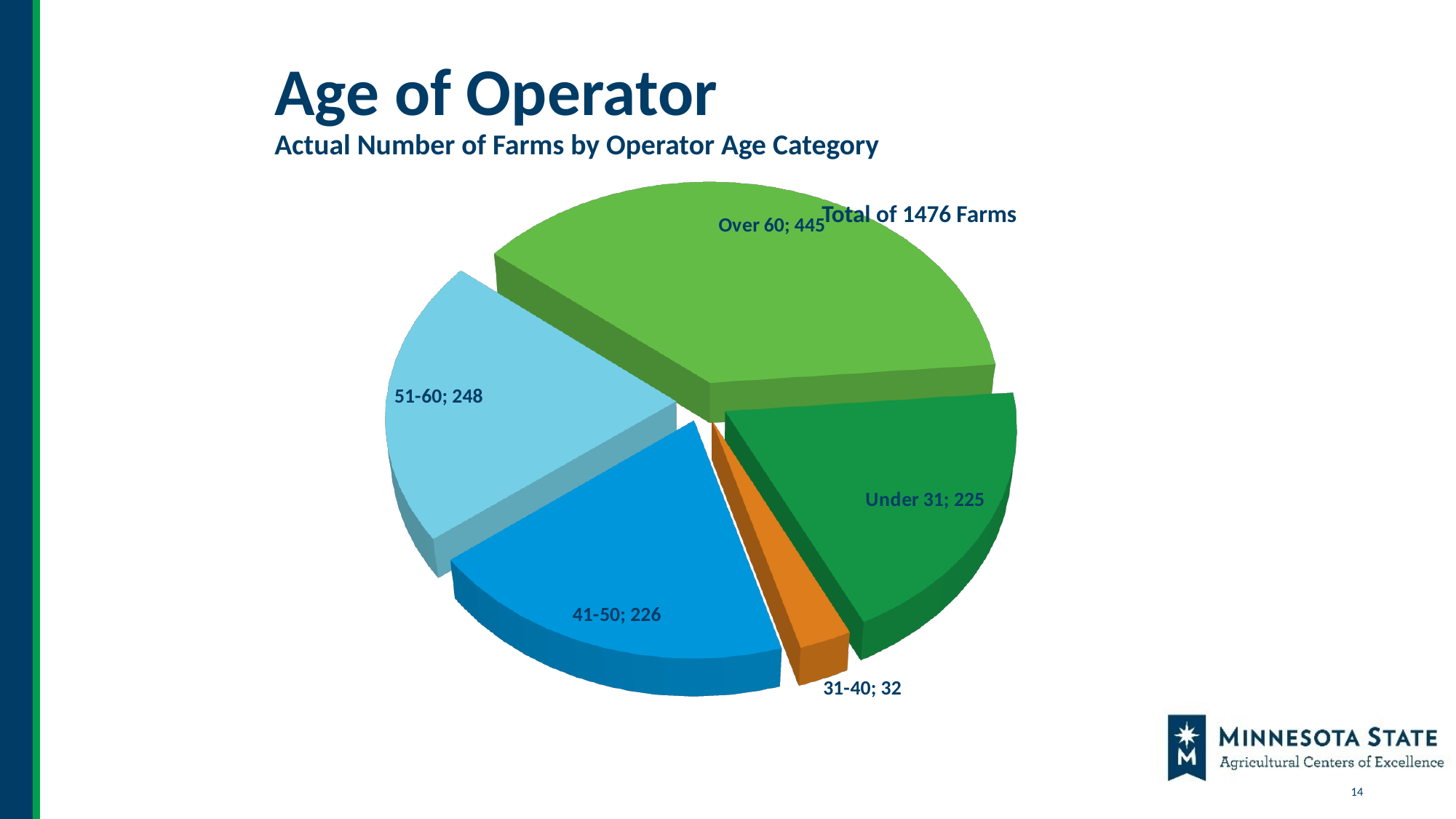
What kind of chart is shown on the slide? Pie chart Which operator age category has the smallest number of farms? 31-40 How many operator age categories are shown in the pie chart? 5 What is the difference in the number of farms between the 41-50 and 31-40 categories? 194 How many farms are in the 31-40 operator age category? 32 What is the difference in the number of farms between the Over 60 and 51-60 categories? 197 How many farms are in the Over 60 operator age category? 445 Which category has more farms, 51-60 or Under 31? 51-60 How many farms are in the 51-60 operator age category? 248 Which operator age category has the largest number of farms? Over 60 How many farms are in the Under 31 operator age category? 225 What total number of farms does the slide state next to the chart? Total of 1476 Farms